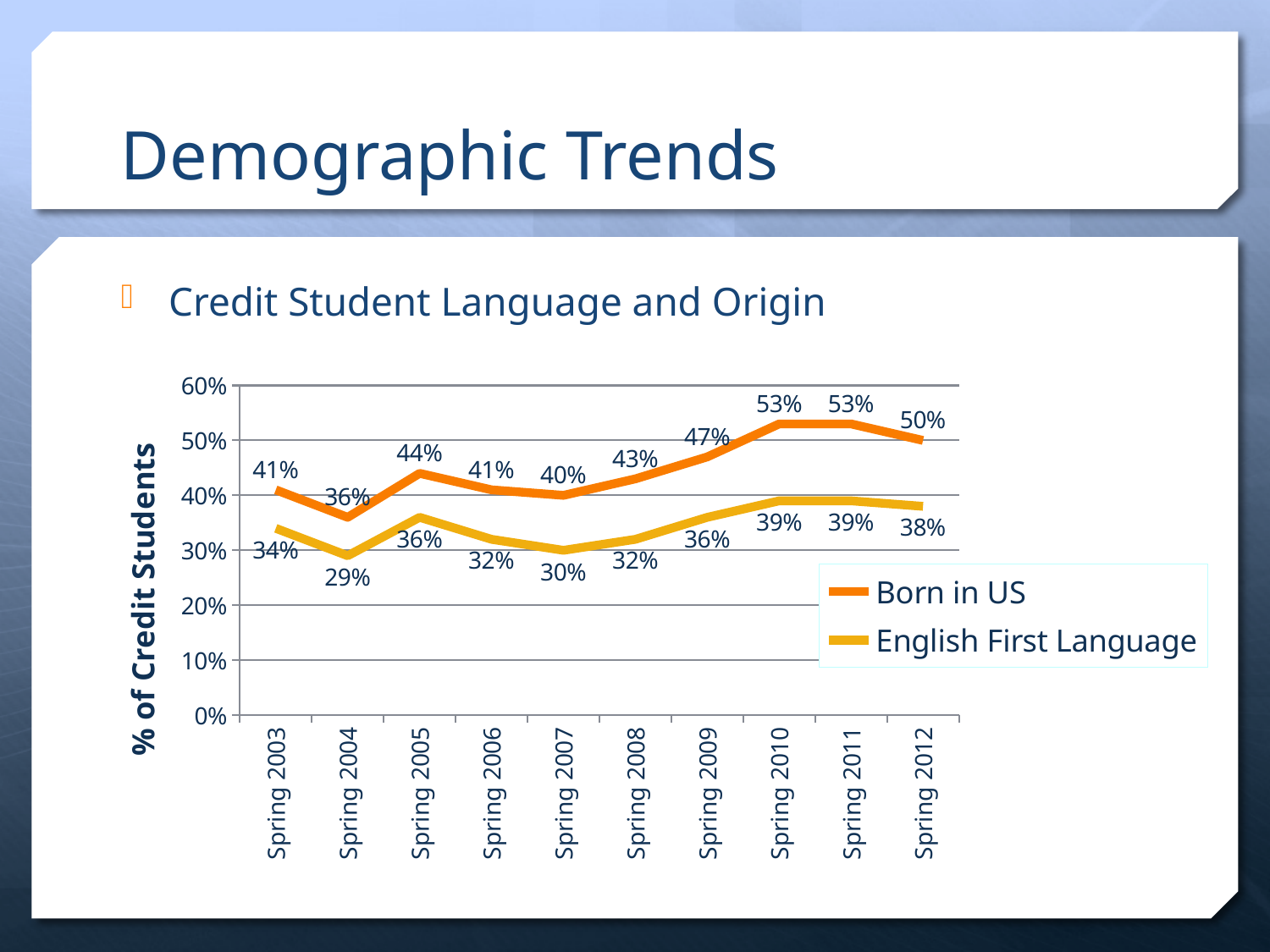
What is the value for English First Language in Spring 2007? 30% What is the highest value reached by the Born in US series? 53% What kind of chart is shown? Line chart How many series does the legend list? 2 What is the label of the y axis? % of Credit Students In which term is the English First Language value lowest? Spring 2004 How many terms are plotted on the x axis? 10 In which term is the Born in US value lowest? Spring 2004 What is the value for Born in US in Spring 2005? 44% Which is larger in Spring 2009: Born in US or English First Language? Born in US What is the value for Born in US in Spring 2012? 50% What is the difference between Born in US and English First Language in Spring 2010? 14%